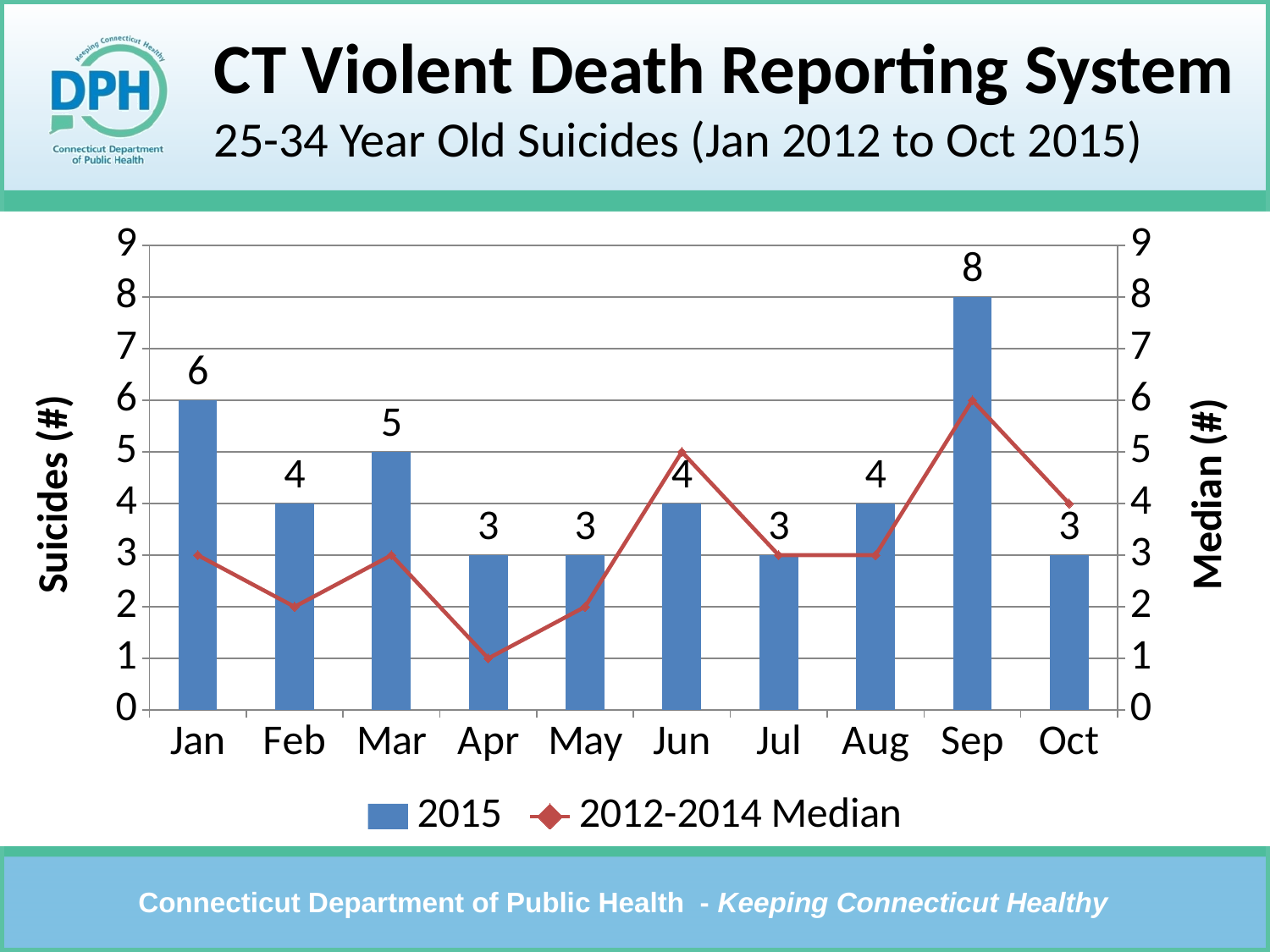
What is the 2012-2014 Median value for Apr? 1 Which month has the highest 2015 value? Sep What is the label of the left vertical axis? Suicides (#) What is the difference between the 2015 values for Sep and Jan? 2 What is the 2015 value for Mar? 5 What kind of chart is used for the 2015 series? bar chart How many series does the legend list? 2 Is the 2015 value for Sep greater or less than 7? greater What is the 2015 value for Jan? 6 How many months are shown on the x axis? 10 What is the 2015 value for Sep? 8 Which is larger, the 2015 value for Feb or the 2015 value for Mar? Mar